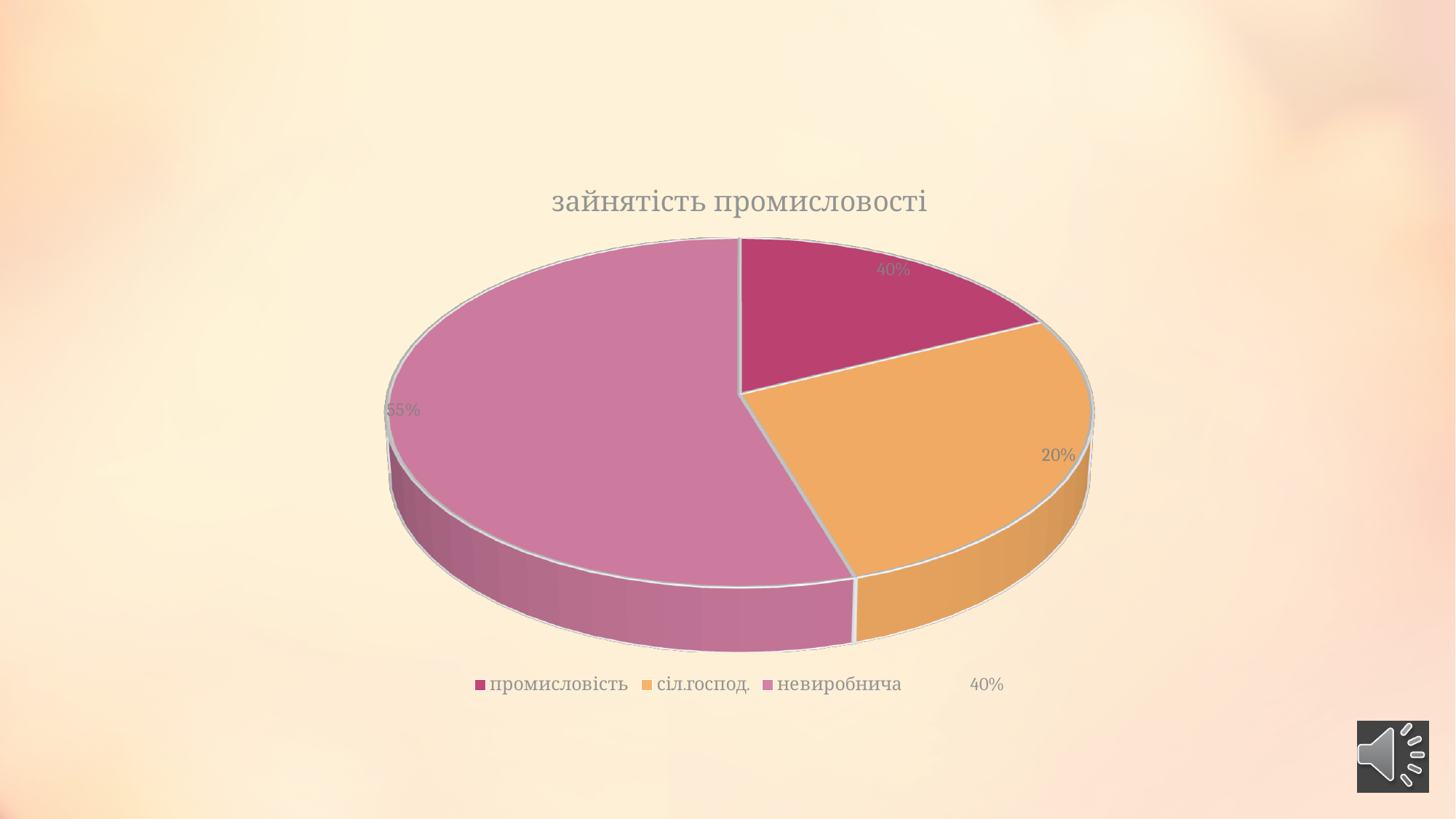
What percentage is labelled on the сіл.господ. slice? 20% Which is larger, the невиробнича slice or the сіл.господ. slice? невиробнича What kind of chart is shown on the slide? pie chart What percentage is labelled on the невиробнича slice? 55% What share of the pie does the невиробнича slice represent according to its label? 55% What percentage is labelled on the промисловість slice? 40% What colour is the невиробнича slice? pink How many slices does the pie chart have? 3 What is the title of the chart? зайнятість промисловості How many entries does the legend list? 3 Which category has the largest slice of the pie? невиробнича